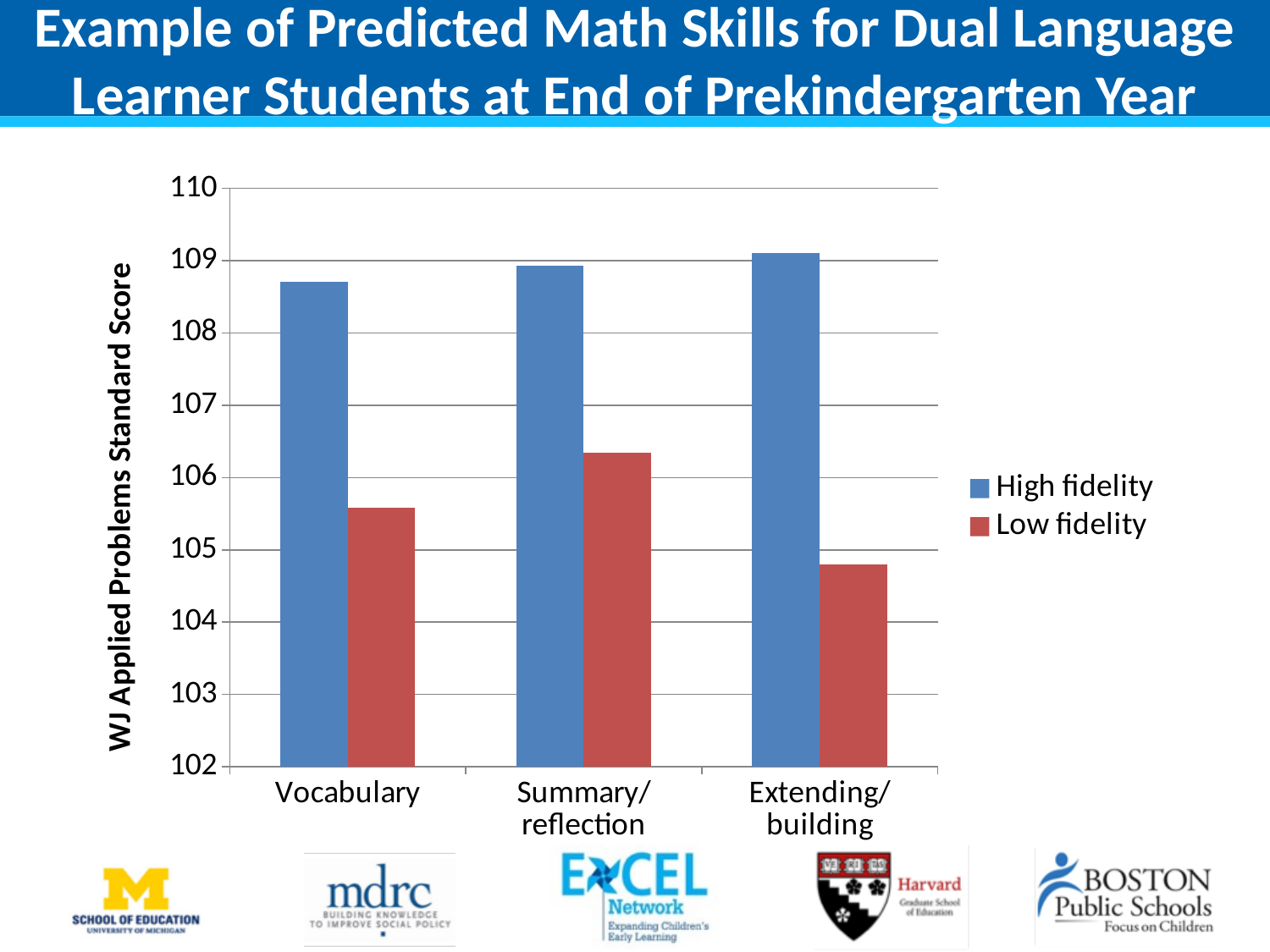
Is the Low fidelity value for Extending/building greater or less than 105? less How many categories are shown on the x axis? 3 Which category has the lowest Low fidelity value? Extending/building Which category has the highest Low fidelity value? Summary/reflection Is the High fidelity value for Vocabulary greater or less than 108? greater What kind of chart is shown on the slide? bar chart What is the label on the vertical axis? WJ Applied Problems Standard Score How many series does the legend list? 2 Is the Low fidelity value for Vocabulary greater or less than 106? less For Vocabulary, which series has the larger value, High fidelity or Low fidelity? High fidelity Do the High fidelity values rise or fall from Vocabulary to Extending/building? rise